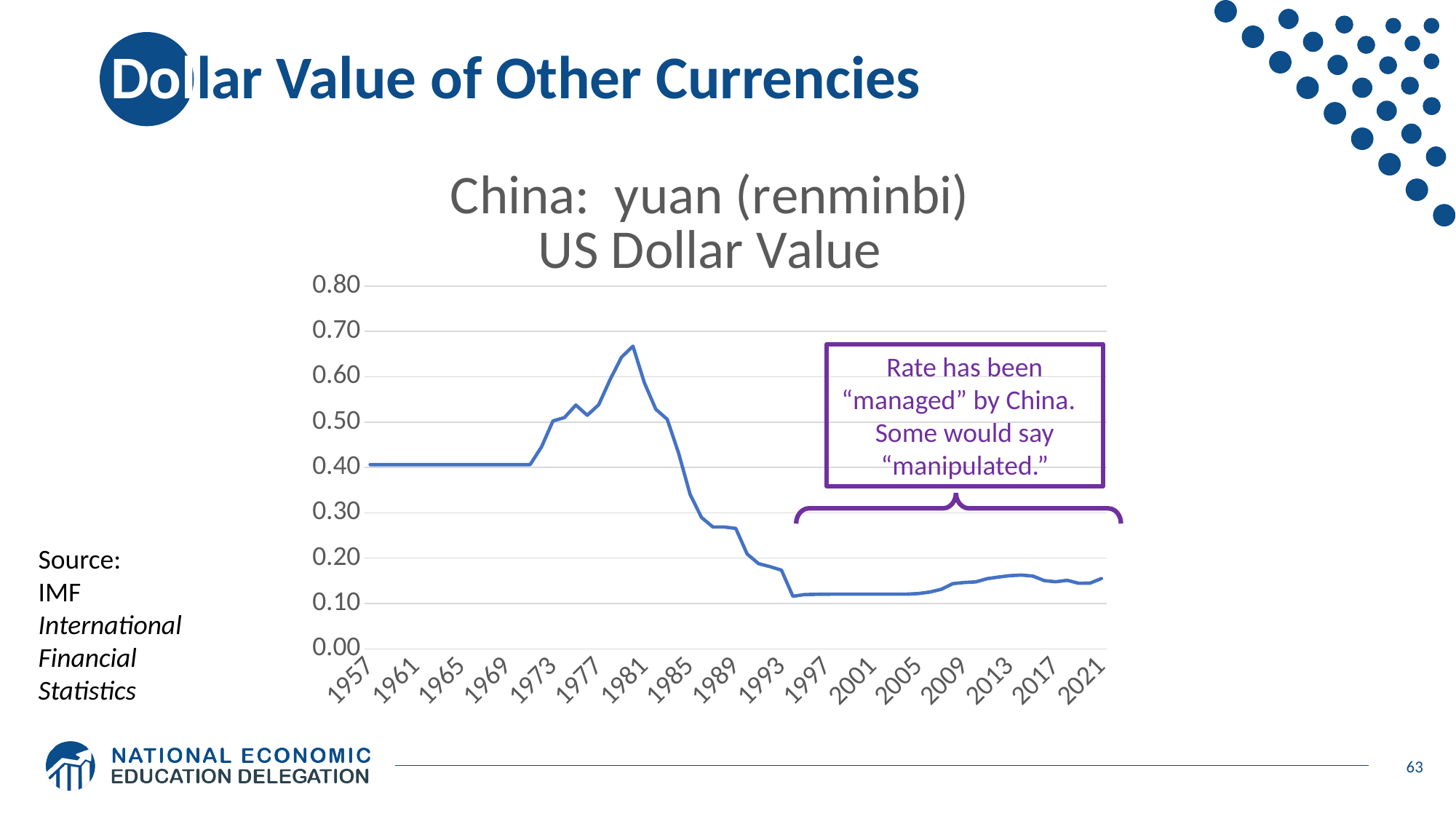
How many year labels are shown on the x axis? 17 Is the value for 1997 greater or less than 0.20? less Is the value for 1989 greater or less than 0.30? less What kind of chart is shown on the slide? line chart What is the highest value shown on the y axis? 0.80 What is the title of the chart? China: yuan (renminbi) US Dollar Value Is the peak value of the line greater or less than 0.60? greater Does the value rise or fall between 1981 and 1993? fall Does the value rise or fall between 1969 and 1981? rise